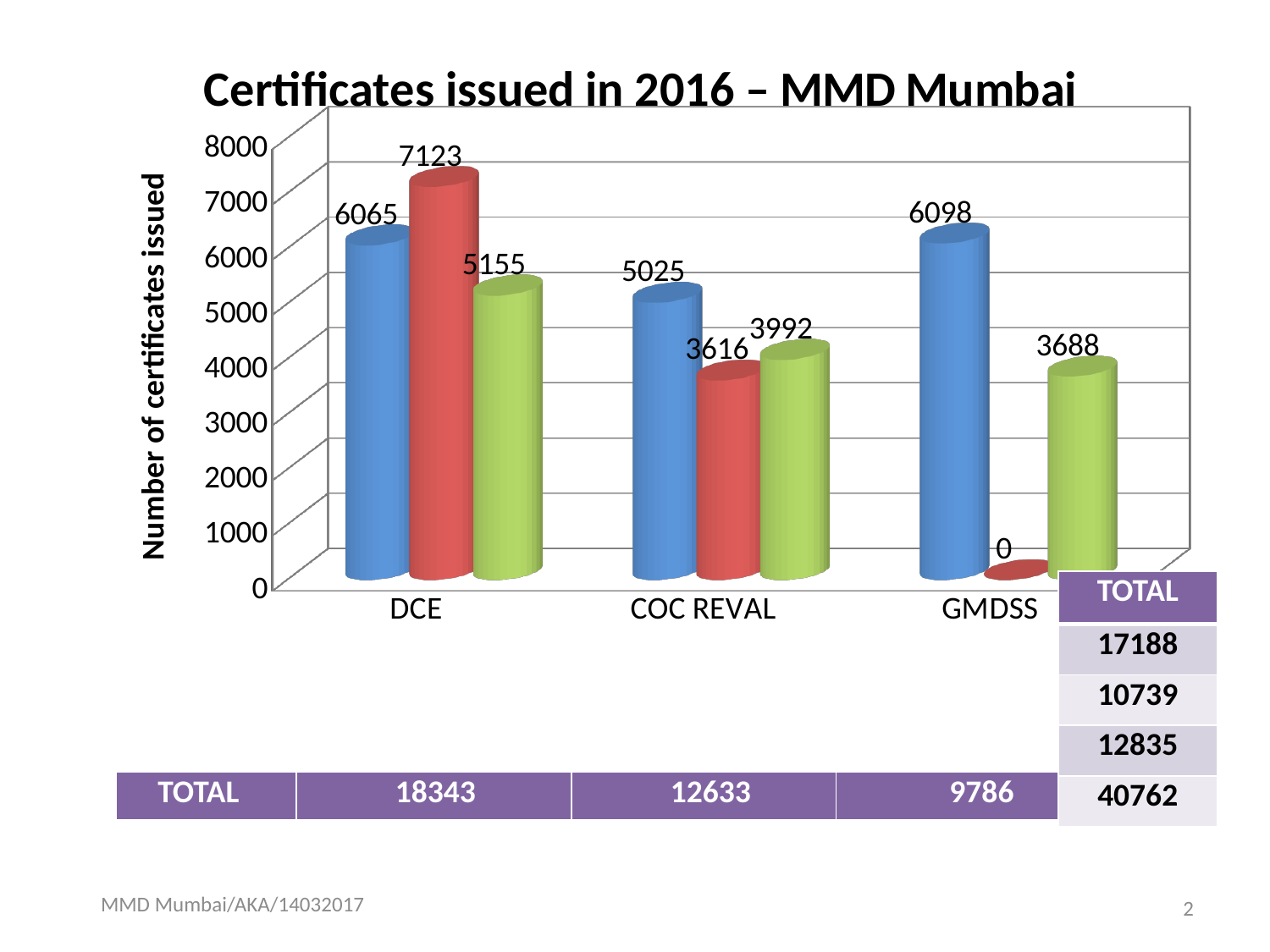
For DCE, how much larger is the red bar than the blue bar? 1058 What is the value of the blue bar for DCE? 6065 Which category has the lowest green bar? GMDSS For COC REVAL, what is the difference between the green bar and the red bar? 376 What is the value of the green bar for GMDSS? 3688 What is the title of the chart? Certificates issued in 2016 – MMD Mumbai What is the value of the red bar for DCE? 7123 How many categories are shown on the x axis? 3 What kind of chart is shown on the slide? Bar chart What is the value of the red bar for GMDSS? 0 Which category has the highest red bar? DCE Which has a larger blue bar, COC REVAL or GMDSS? GMDSS